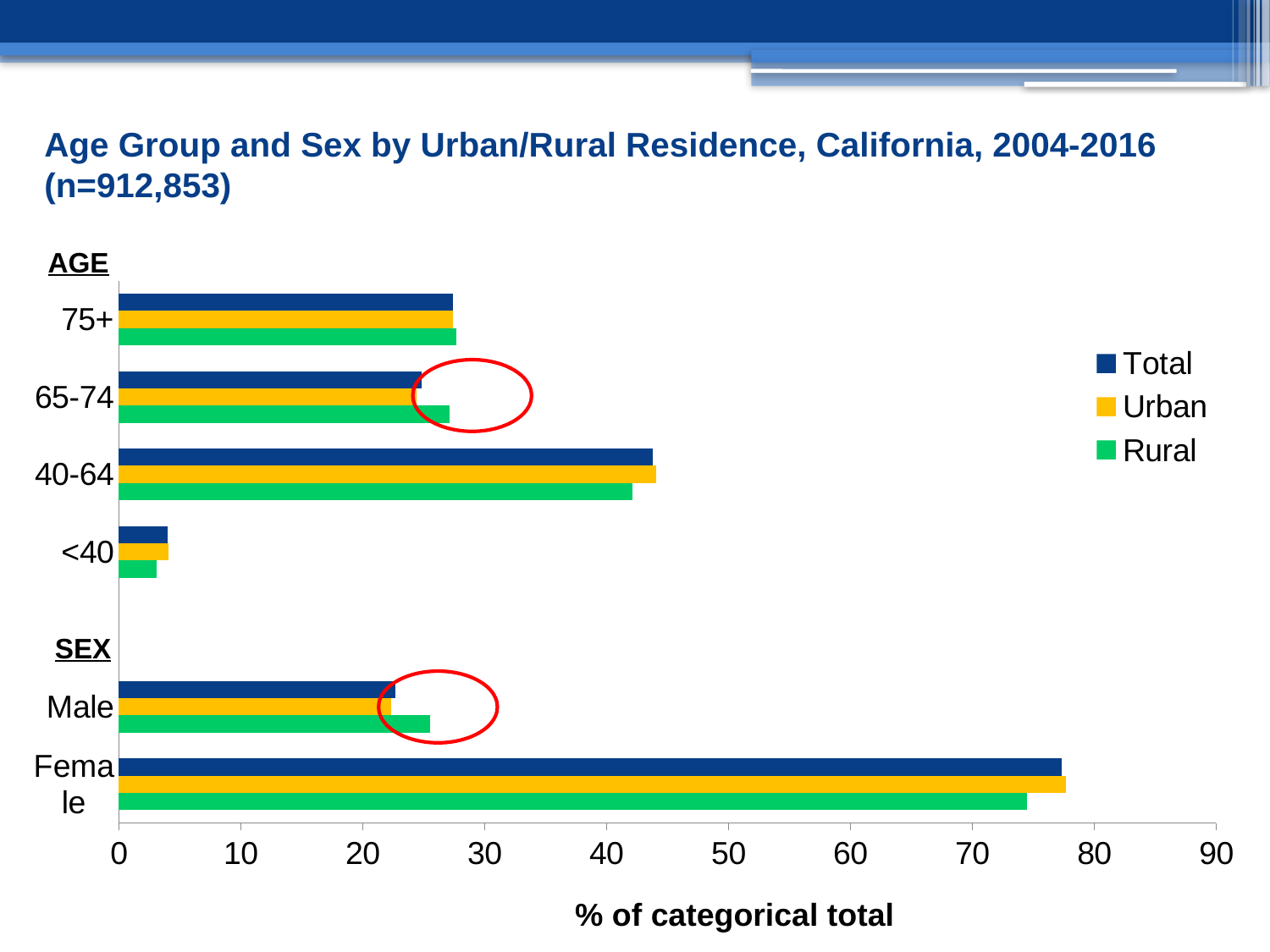
What are the entries in the chart legend? Total, Urban, Rural Is the Urban value for Female greater or less than 70? greater Which category has the highest Total value? Female How many categories are plotted on the chart? 6 For Female, which is larger: the Urban value or the Rural value? Urban Is the Total value for <40 greater or less than 10? less What kind of chart is shown on the slide? bar chart What is the title of the x axis? % of categorical total For Male, which is larger: the Urban value or the Rural value? Rural Is the Rural value for 40-64 greater or less than 40? greater Which category has the lowest Rural value? <40 How many series does the legend list? 3